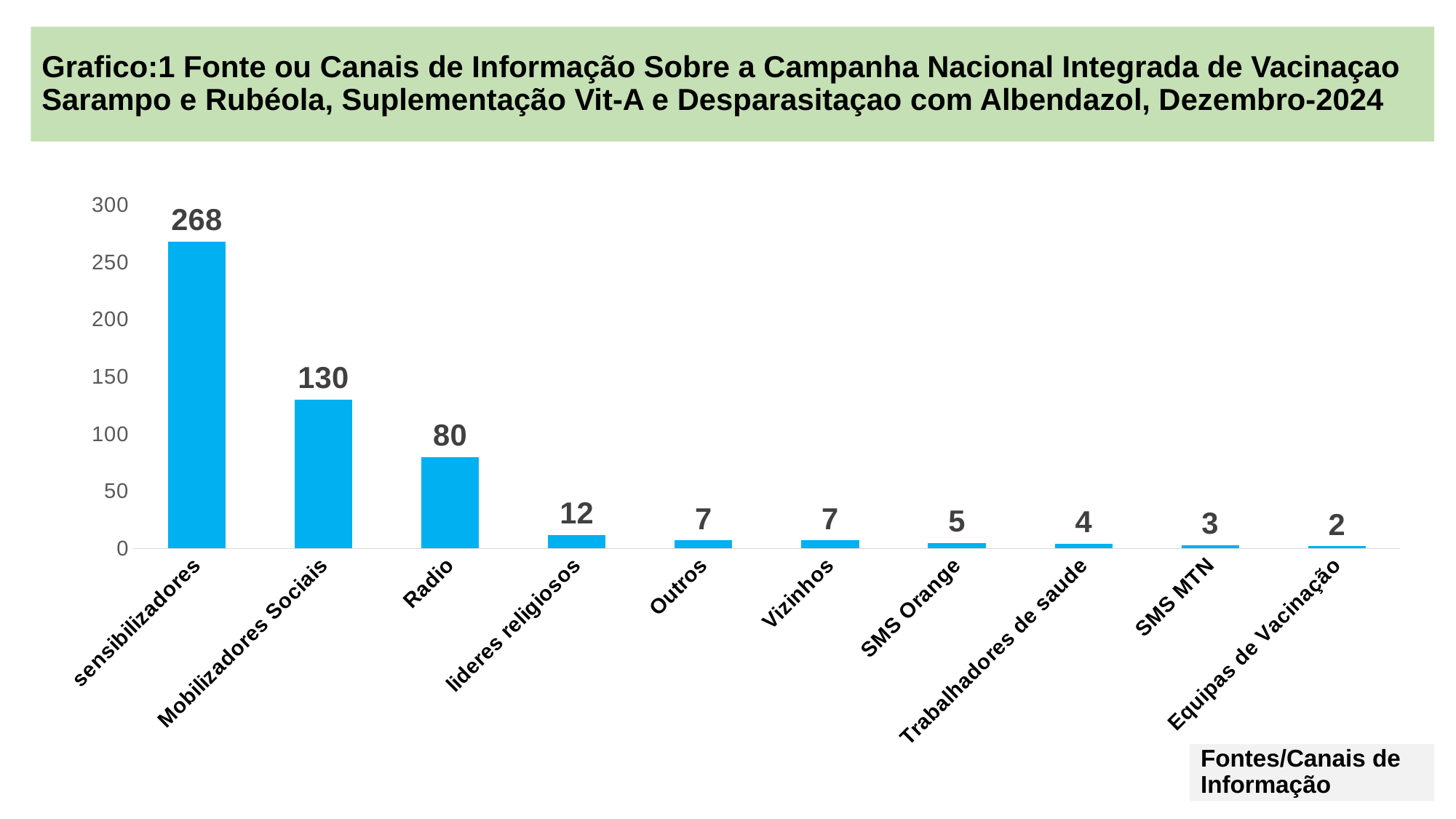
Do the values rise or fall from left to right along the x axis? fall Which category has the highest value? sensibilizadores Is the value for Mobilizadores Sociais greater or less than 150? less How many categories are shown on the x axis? 10 What is the difference between the values for sensibilizadores and Mobilizadores Sociais? 138 What is the value for SMS Orange? 5 What kind of chart is shown on the slide? bar chart Which is larger, the value for SMS MTN or the value for Trabalhadores de saude? Trabalhadores de saude What is the value for Radio? 80 What is the difference between the values for Radio and lideres religiosos? 68 What is the value for Mobilizadores Sociais? 130 Which category has the lowest value? Equipas de Vacinação